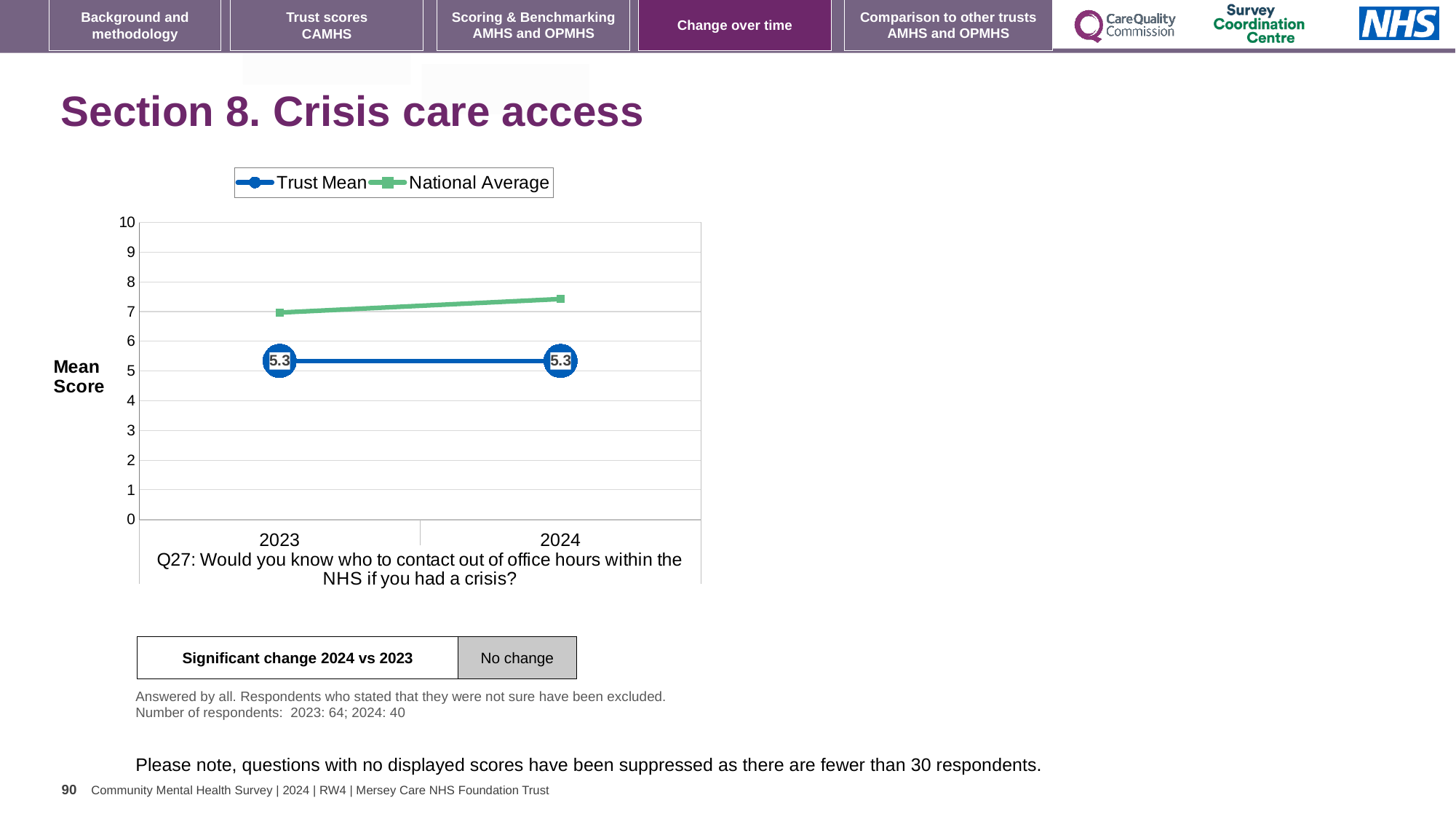
What is the label of the y axis? Mean Score What is the difference between the Trust Mean scores for 2024 and 2023? 0 What is the Trust Mean score for 2024? 5.3 How many years are plotted on the x axis? 2 Does the Trust Mean rise, fall or stay the same from 2023 to 2024? stays the same What kind of chart is shown on the slide? line chart Is the National Average value for 2024 greater or less than 7? greater Is the National Average value for 2023 greater or less than 6? greater Does the National Average rise or fall from 2023 to 2024? rises In 2024, which is larger: the Trust Mean or the National Average? National Average How many series does the legend list? 2 What is the Trust Mean score for 2023? 5.3